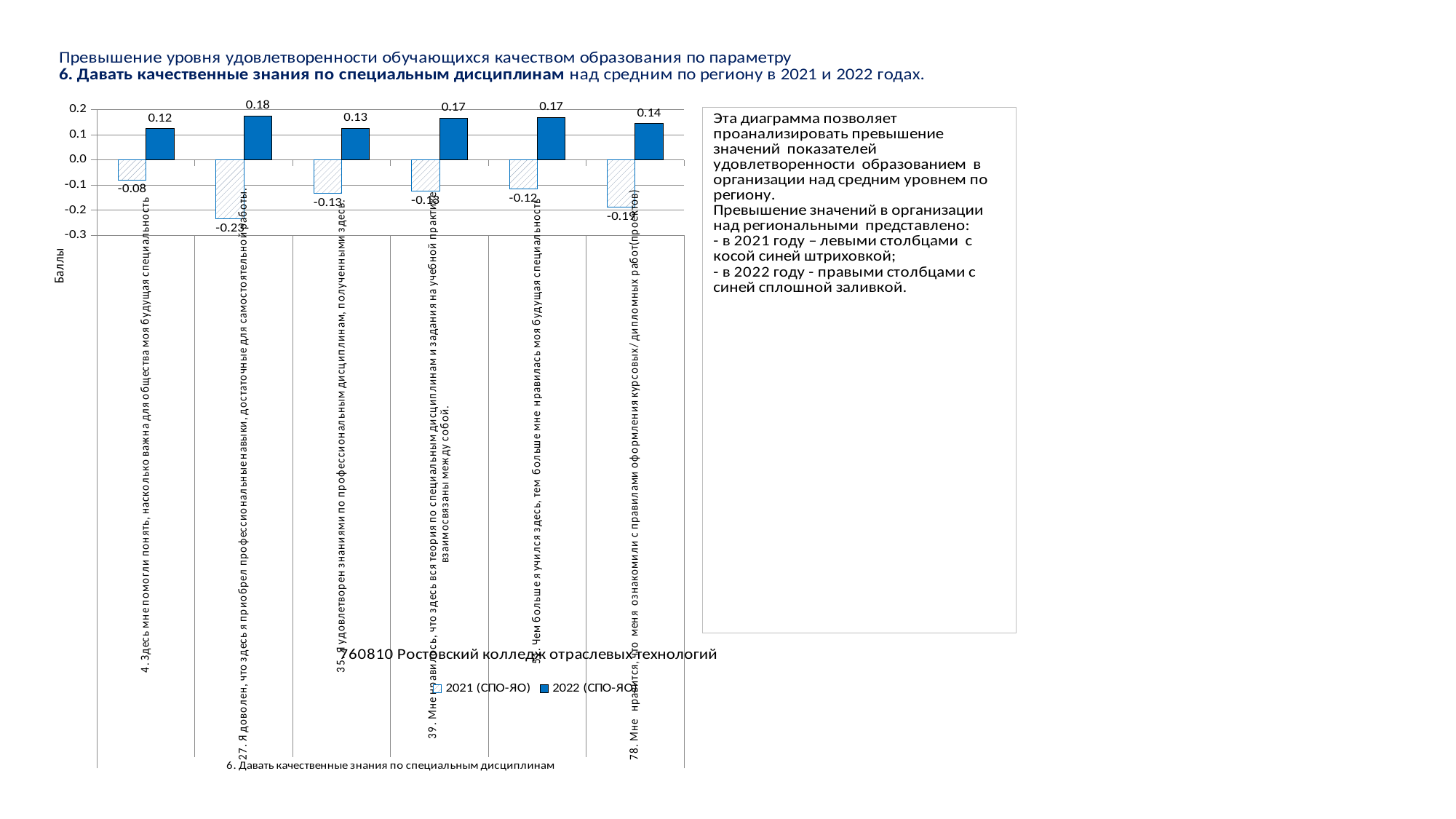
Is the 2021 value for category 27 greater or less than -0.2? less Which category has the highest 2022 (СПО-ЯО) value? 27. Я доволен, что здесь я приобрел профессиональные навыки, достаточные для самостоятельной работы What is the difference between the 2022 and 2021 values for category 35? 0.26 What is the 2021 (СПО-ЯО) value for category 27 ("Я доволен, что здесь я приобрел профессиональные навыки, достаточные для самостоятельной работы")? -0.23 How many series does the chart legend list? 2 What is the 2022 (СПО-ЯО) value for category 35 ("Я удовлетворен знаниями по профессиональным дисциплинам, полученными здесь")? 0.13 Which is larger: the 2022 value for category 27 or the 2022 value for category 35? Category 27 Which category has the lowest 2021 (СПО-ЯО) value? 27. Я доволен, что здесь я приобрел профессиональные навыки, достаточные для самостоятельной работы What kind of chart is shown on the slide? Bar chart What is the title of the vertical axis of the chart? Баллы What is the 2022 (СПО-ЯО) value for category 4 ("Здесь мне помогли понять, насколько важна для общества моя будущая специальность")? 0.12 How many categories are shown on the x axis of the chart? 6